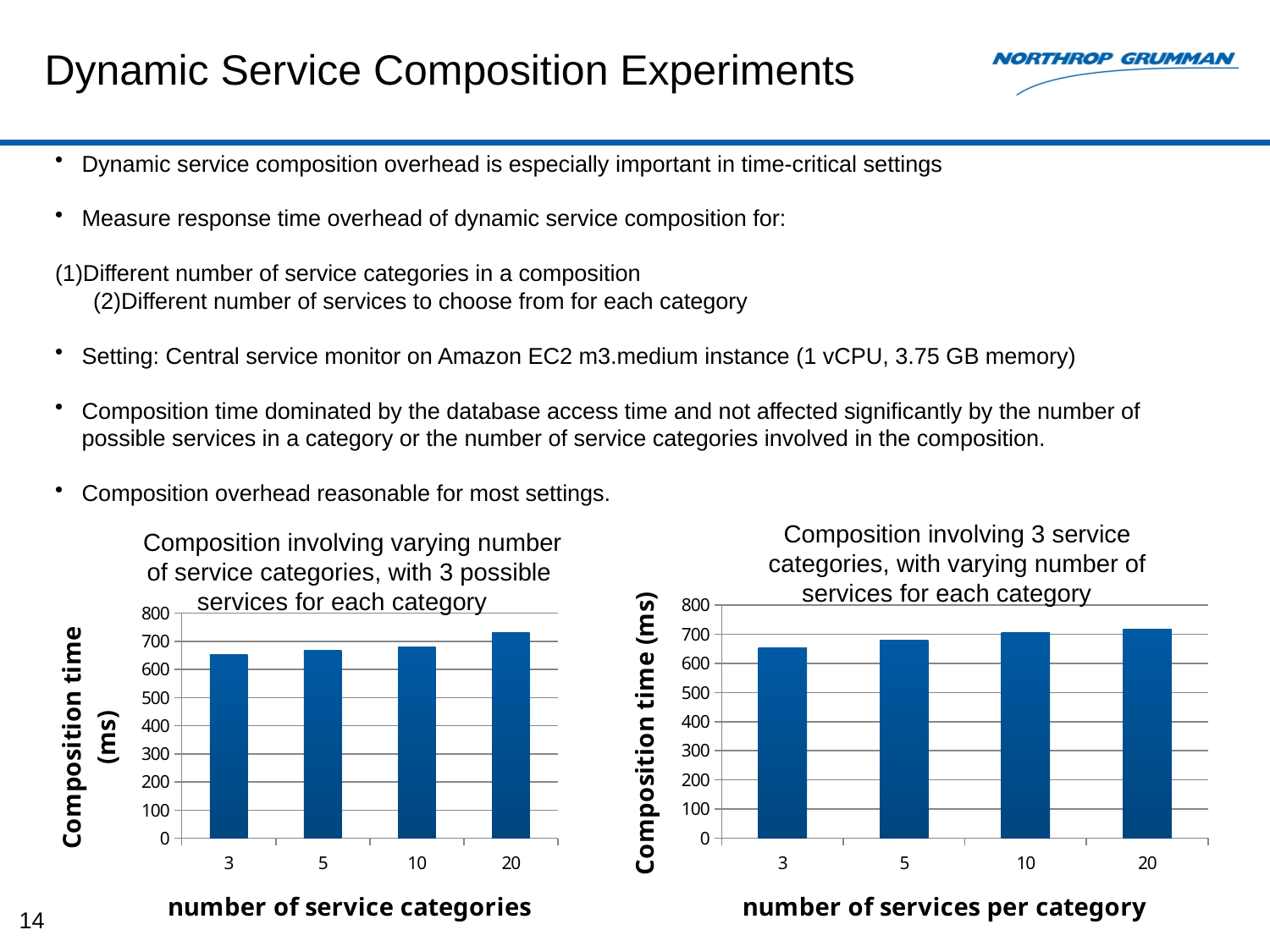
In the right chart (varying number of services per category), which number of services per category has the highest composition time? 20 What kind of chart is the left chart titled 'Composition involving varying number of service categories, with 3 possible services for each category'? bar chart In the right chart (varying number of services per category), which number of services per category has the lowest composition time? 3 In the right chart (varying number of services per category), is the composition time for 20 services per category greater or less than 700? greater In the left chart (varying number of service categories), which number of service categories has the highest composition time? 20 In the right chart (varying number of services per category), is the composition time for 3 services per category greater or less than 600? greater In the left chart (varying number of service categories), is the composition time for 5 service categories greater or less than 700? less In the right chart (varying number of services per category), does the composition time rise or fall as the number of services per category increases? rise What is the x-axis label of the left chart (varying number of service categories)? number of service categories How many bars are plotted in the right chart titled 'Composition involving 3 service categories, with varying number of services for each category'? 4 In the left chart (varying number of service categories), which number of service categories has the lowest composition time? 3